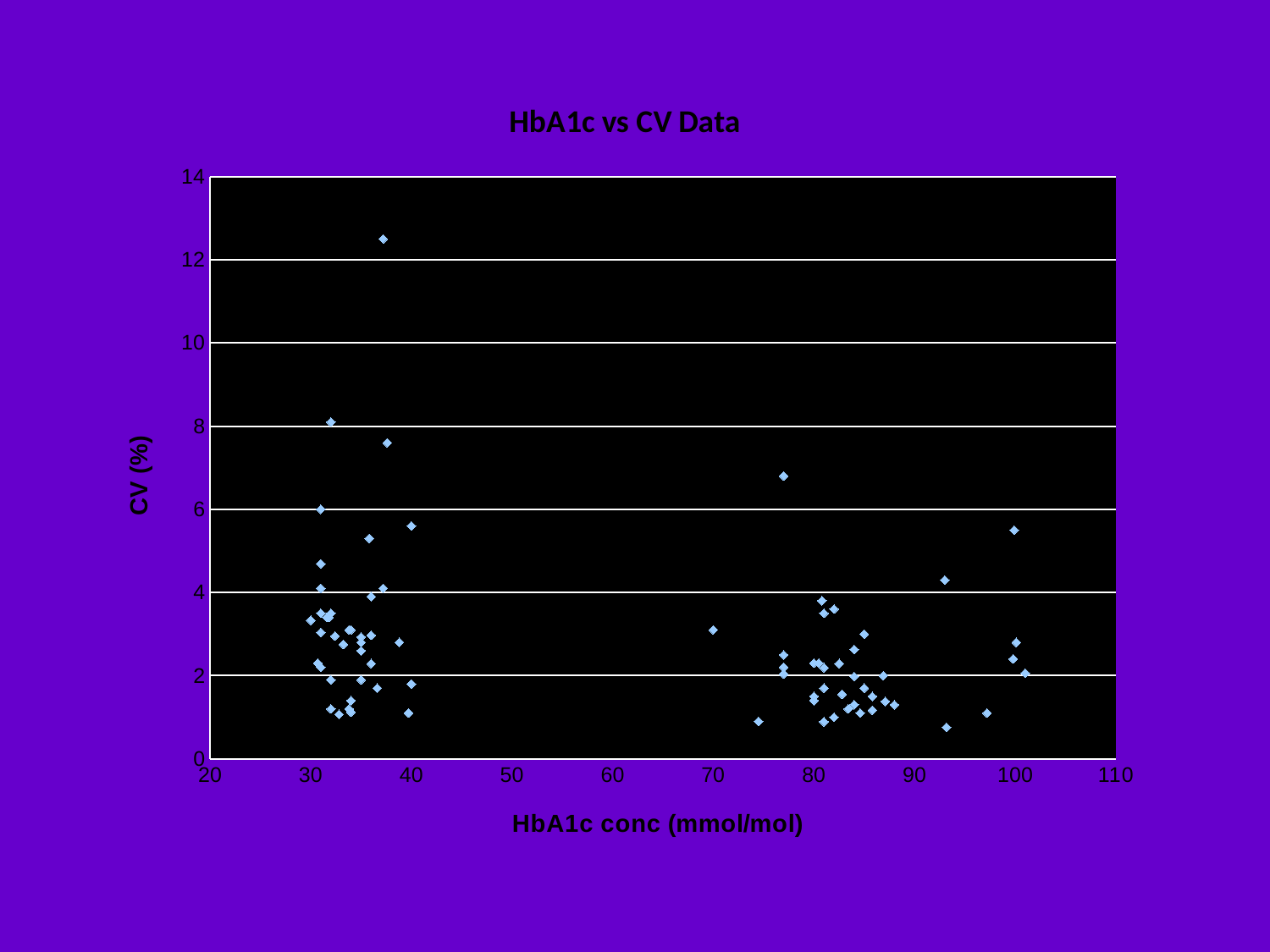
Is the CV (%) value of the point plotted near an HbA1c conc of 77 mmol/mol greater or less than 8? less Which has the higher CV (%): the highest point in the cluster around 30-40 mmol/mol or the highest point in the cluster around 75-100 mmol/mol? the cluster around 30-40 mmol/mol What is the label of the x axis? HbA1c conc (mmol/mol) What kind of chart is shown on the slide? scatter plot Is the highest CV (%) value plotted greater or less than 14? less Is the CV (%) value of the point plotted near an HbA1c conc of 100 mmol/mol with the highest CV greater or less than 4? greater What is the maximum value shown on the y axis (CV (%))? 14 What is the title of the chart? HbA1c vs CV Data